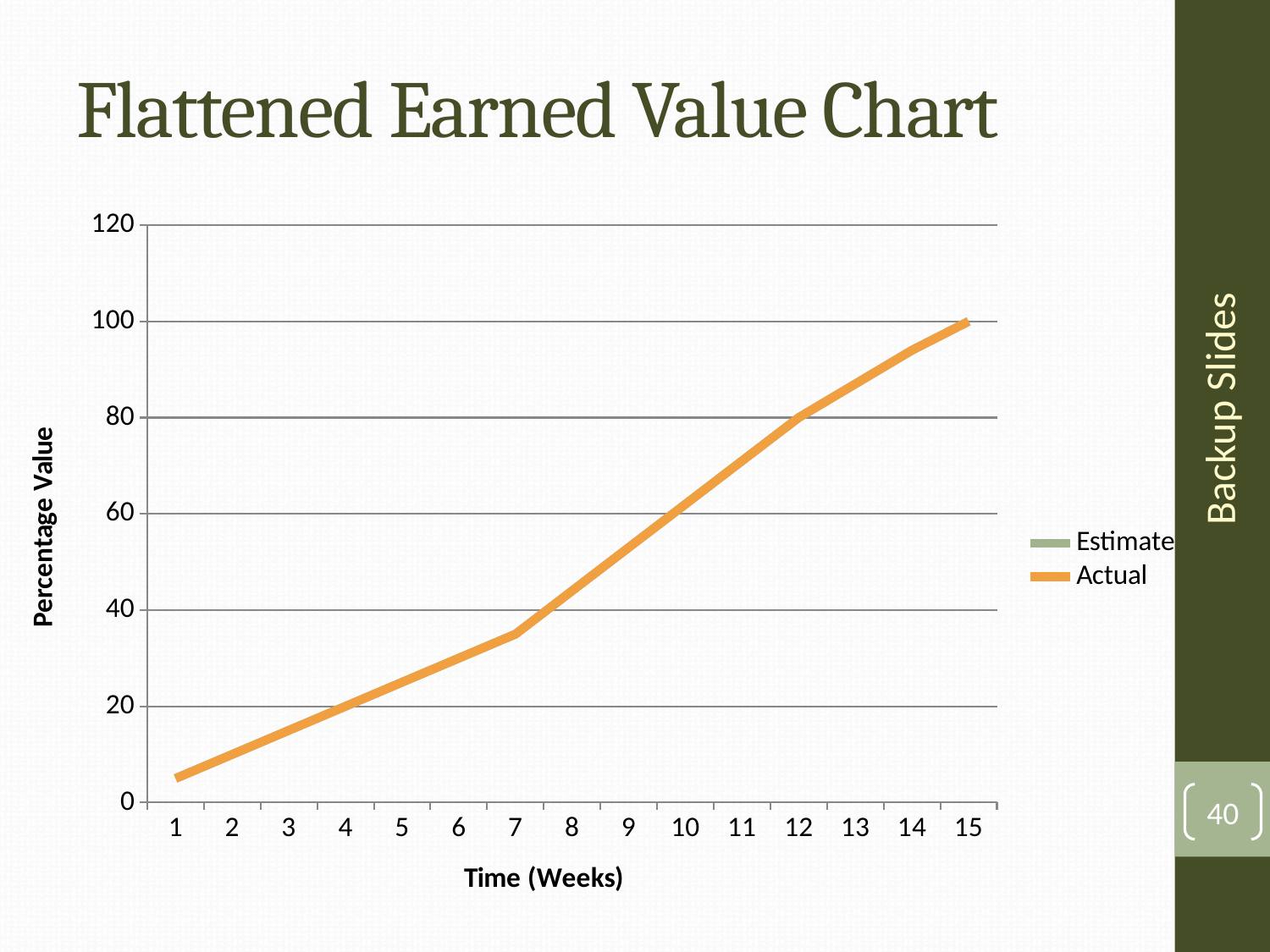
Do the values rise or fall as the weeks increase along the x axis? rise What is the Actual value at week 15? 100 At which week is the Actual value highest? 15 What is the Actual value at week 12? 80 At which week is the Actual value lowest? 1 What is the title of the chart? Flattened Earned Value Chart Which is larger, the Actual value at week 5 or at week 9? week 9 How many weeks are plotted along the x axis? 15 Is the Actual value at week 7 greater or less than 40? less How many series does the legend list? 2 What kind of chart is shown on the slide? line chart